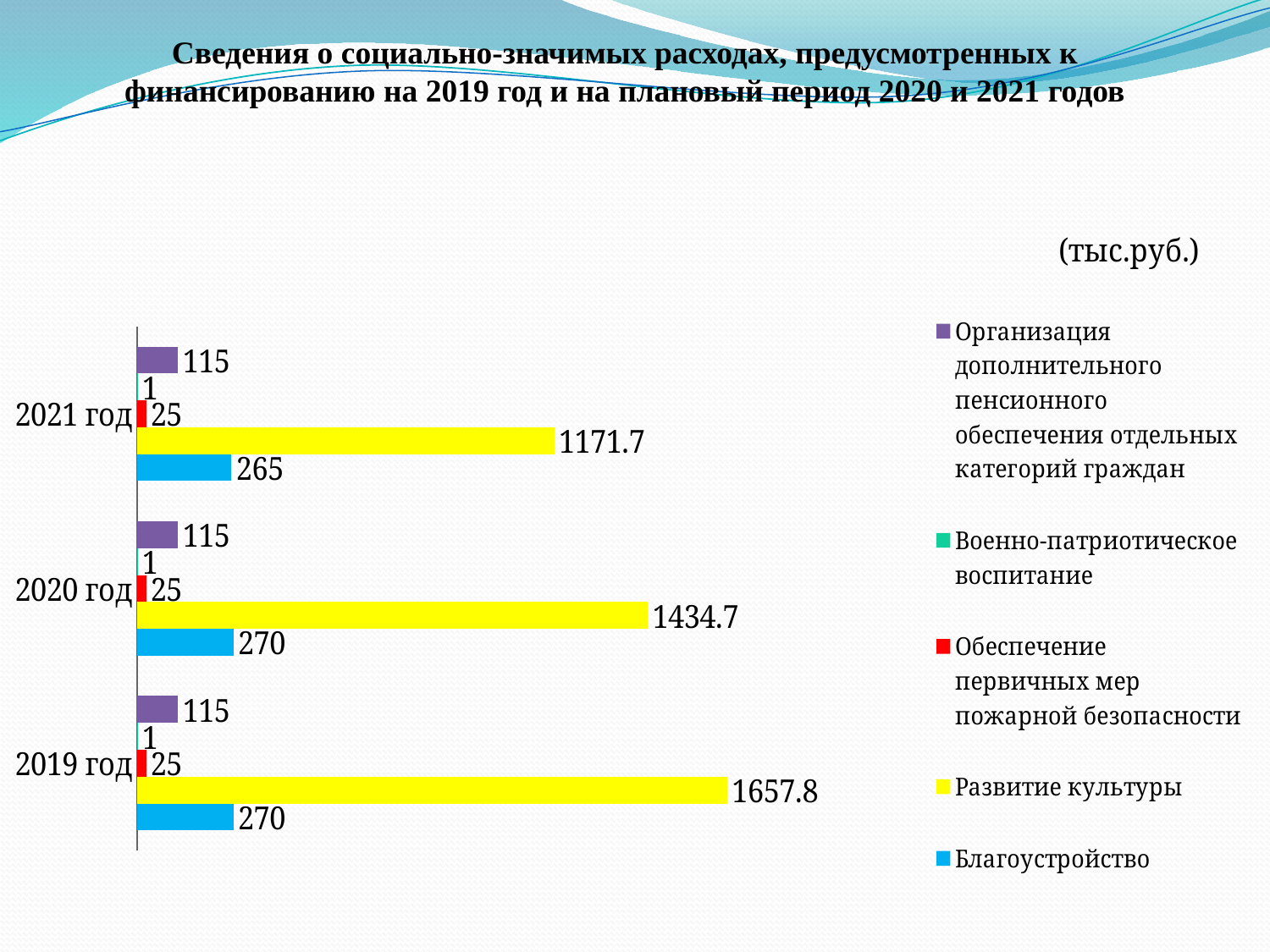
What is the value for Развитие культуры in 2021 год? 1171.7 What unit is indicated for the chart values? тыс.руб. What kind of chart is shown on the slide? Bar chart How many series does the legend list? 5 Does the value for Развитие культуры rise or fall from 2019 год to 2021 год? Fall What is the value for Развитие культуры in 2019 год? 1657.8 What is the value for Благоустройство in 2021 год? 265 What is the value for Обеспечение первичных мер пожарной безопасности in 2020 год? 25 How many year categories are shown on the chart? 3 Which series has the highest value in 2020 год? Развитие культуры Which series has the lowest value in 2019 год? Военно-патриотическое воспитание What is the difference between the Развитие культуры values for 2019 год and 2021 год? 486.1